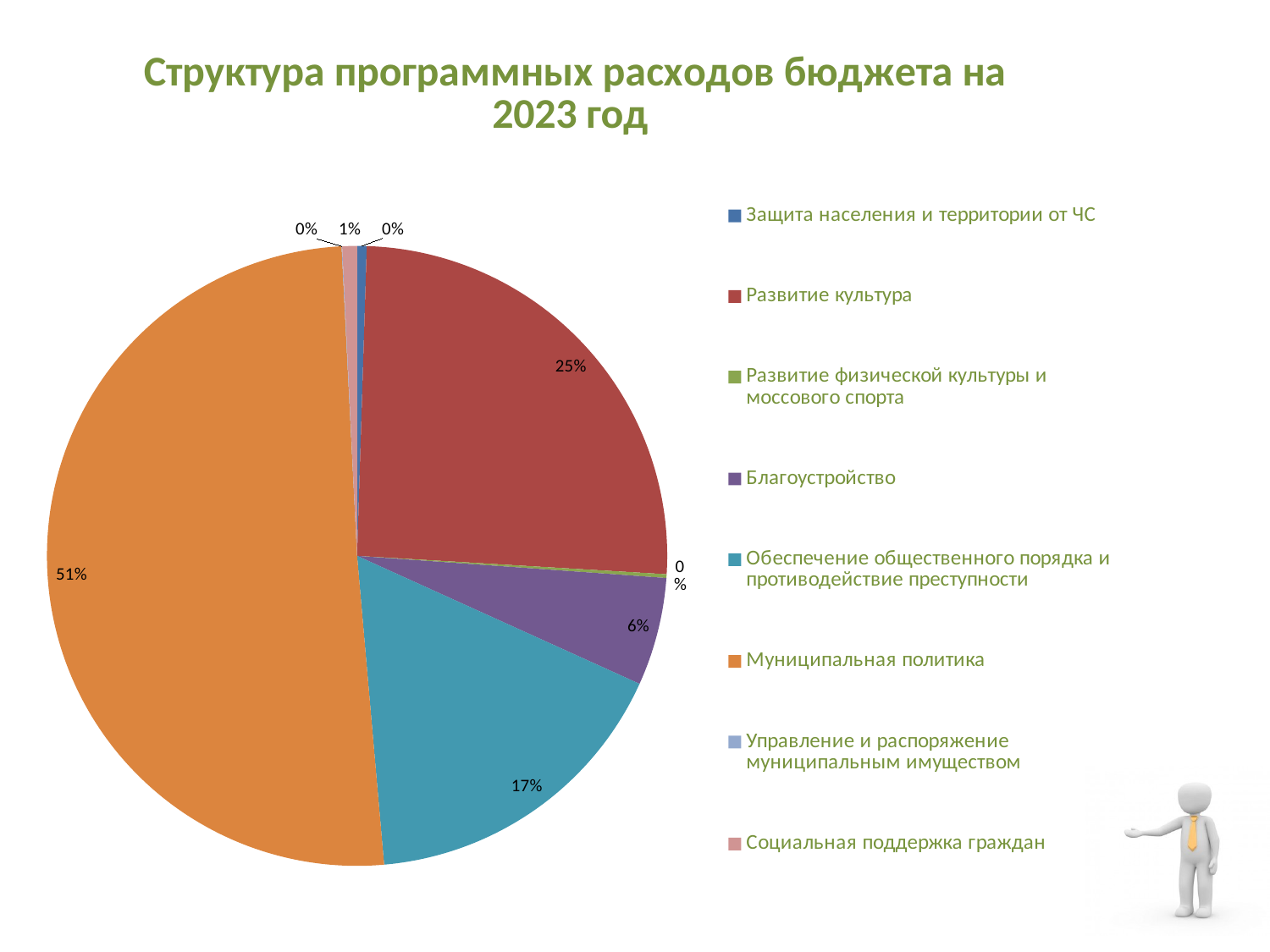
Which is larger: the slice for Развитие культура or the slice for Благоустройство? Развитие культура How many categories does the legend list? 8 What share of the pie does Муниципальная политика have? 51% What is the difference between the shares of Муниципальная политика and Развитие культура? 26% What is the difference between the shares of Обеспечение общественного порядка и противодействие преступности and Благоустройство? 11% Which category has the largest slice of the pie? Муниципальная политика What share of the pie does Развитие культура have? 25% What share of the pie does Благоустройство have? 6% What is the title of the chart? Структура программных расходов бюджета на 2023 год What kind of chart is shown on the slide? pie chart